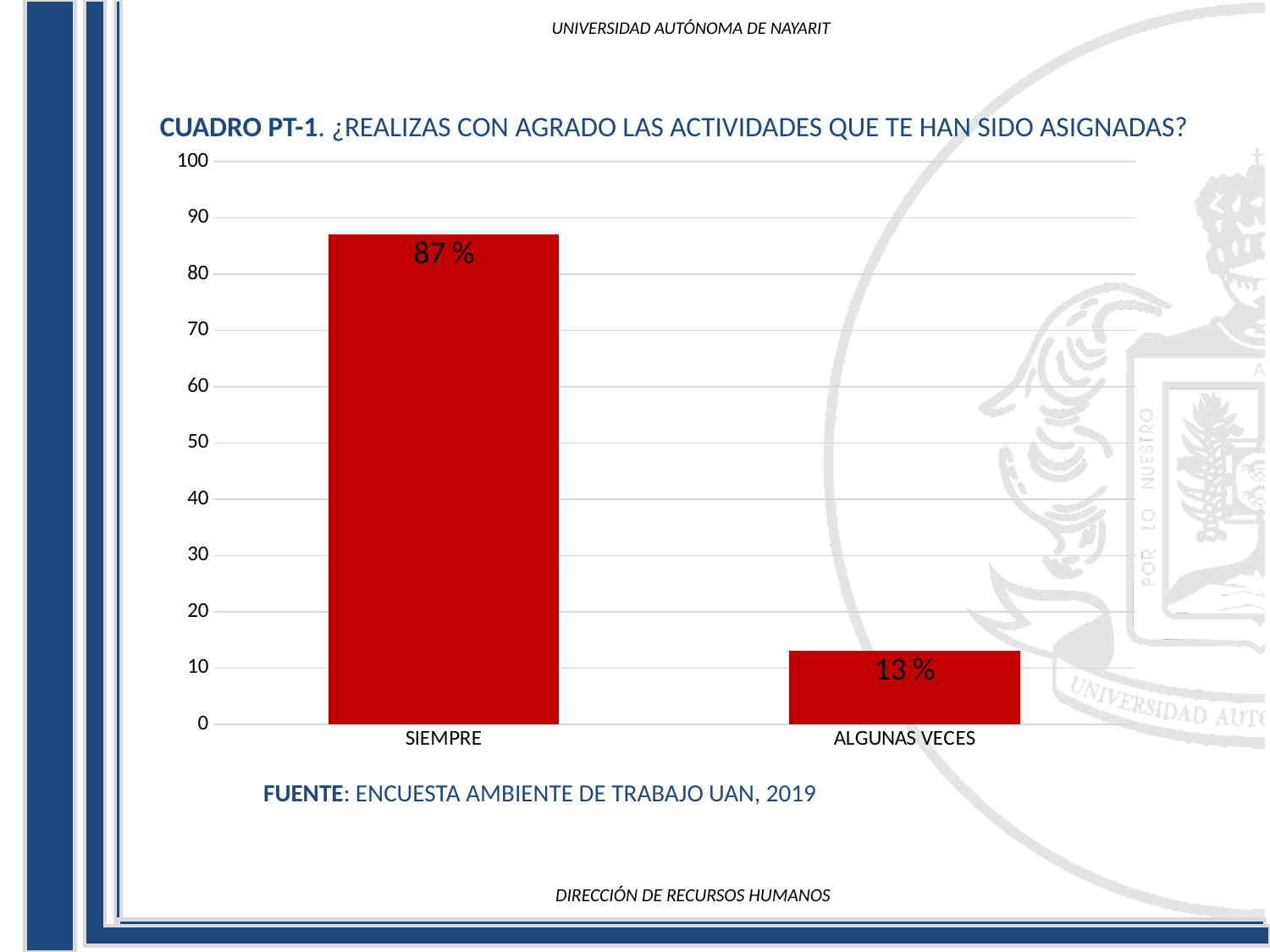
What is the value for ALGUNAS VECES? 13 % What is the difference between the values for SIEMPRE and ALGUNAS VECES? 74 % Which category has the lowest value? ALGUNAS VECES What is the value for SIEMPRE? 87 % What is the source cited below the chart? ENCUESTA AMBIENTE DE TRABAJO UAN, 2019 What colour are the bars in the chart? Red Which category has the highest value? SIEMPRE How many categories are shown on the chart? 2 What kind of chart is shown on the slide? Bar chart Is the value for ALGUNAS VECES greater or less than 20? less Is the value for SIEMPRE greater or less than 80? greater Which is larger, the value for SIEMPRE or the value for ALGUNAS VECES? SIEMPRE